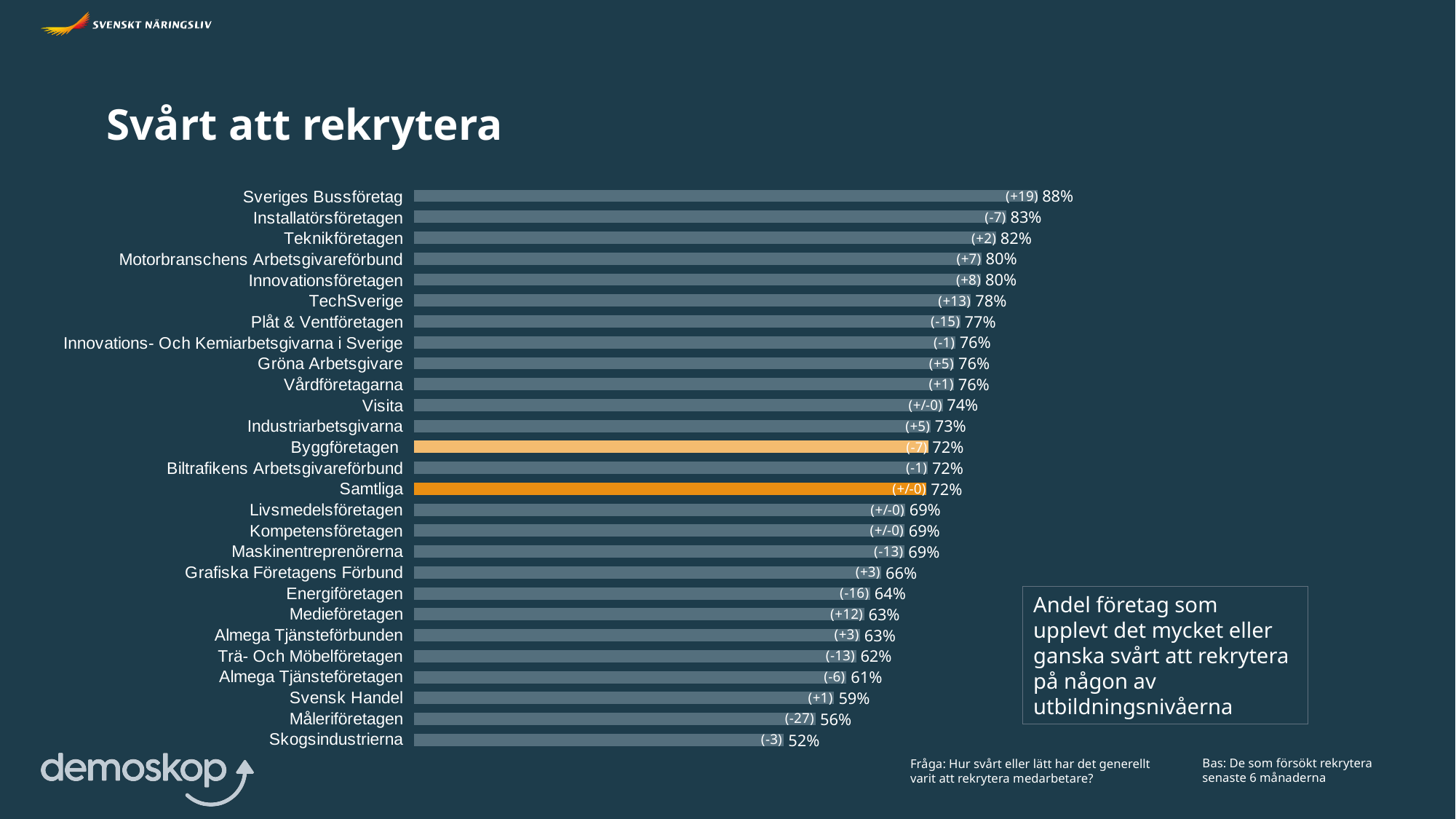
What is the value for Sveriges Bussföretag? 88% What is the value for TechSverige? 78% What kind of chart is shown on the slide? Bar chart Which category has the highest value? Sveriges Bussföretag What is the difference between the values for Sveriges Bussföretag and Skogsindustrierna? 36 percentage points What is the title of the slide? Svårt att rekrytera What is the change shown in parentheses for Måleriföretagen? -27 What is the value for Skogsindustrierna? 52% Which category has the lowest value? Skogsindustrierna Which is larger, the value for Energiföretagen or the value for Svensk Handel? Energiföretagen What is the value for Samtliga? 72% How many categories are shown in the chart? 27